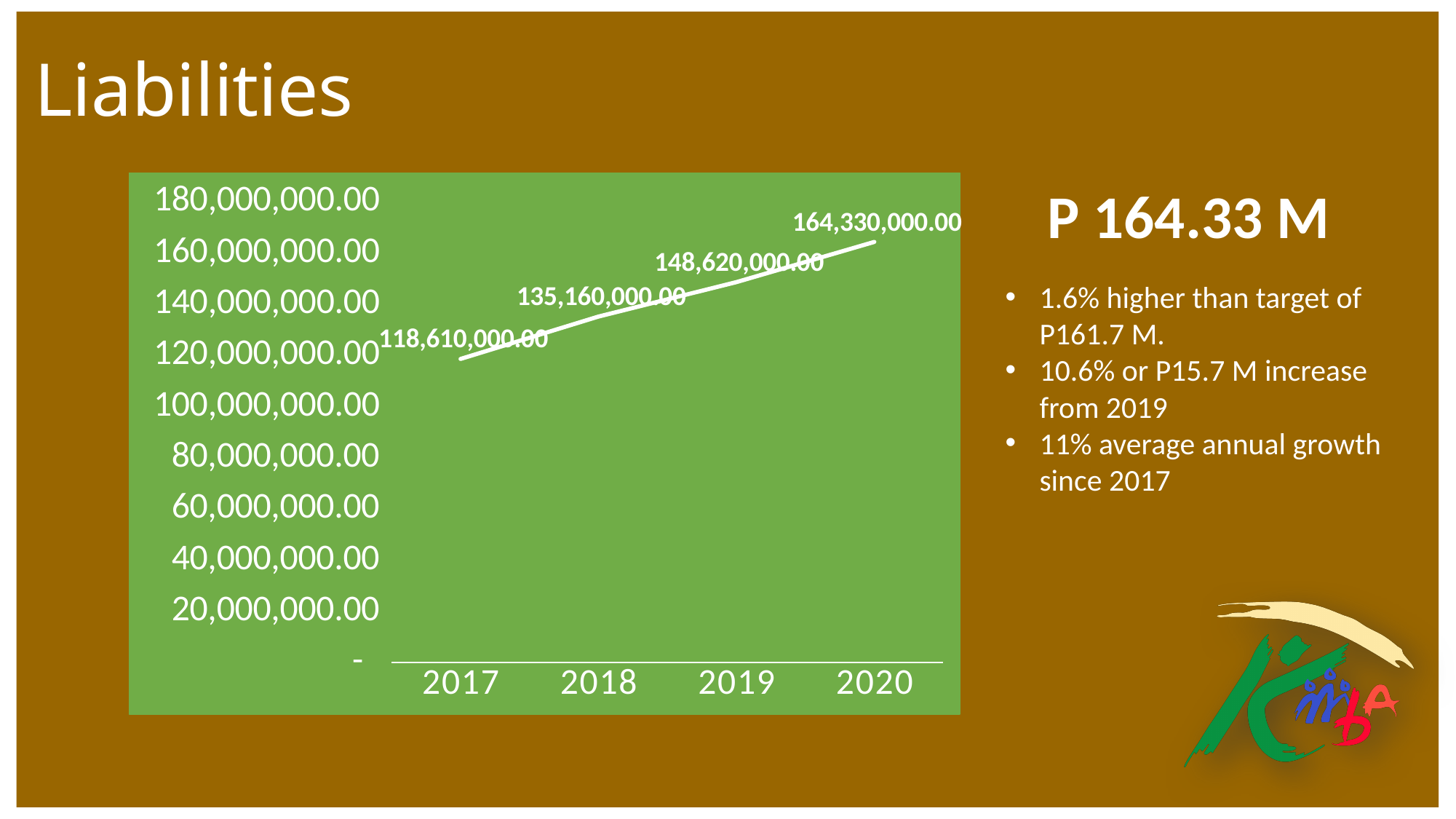
What is the value for 2020? 164,330,000.00 What is the value for 2017? 118,610,000.00 What is the value for 2018? 135,160,000.00 Which year has the lowest value? 2017 How many years are plotted on the chart? 4 What kind of chart is shown on the slide? line chart Which is larger, the value for 2018 or the value for 2019? 2019 What is the difference between the values for 2020 and 2019? 15,710,000.00 Is the value for 2019 greater or less than 140,000,000.00? greater What is the difference between the values for 2018 and 2017? 16,550,000.00 What is the value for 2019? 148,620,000.00 Which year has the highest value? 2020